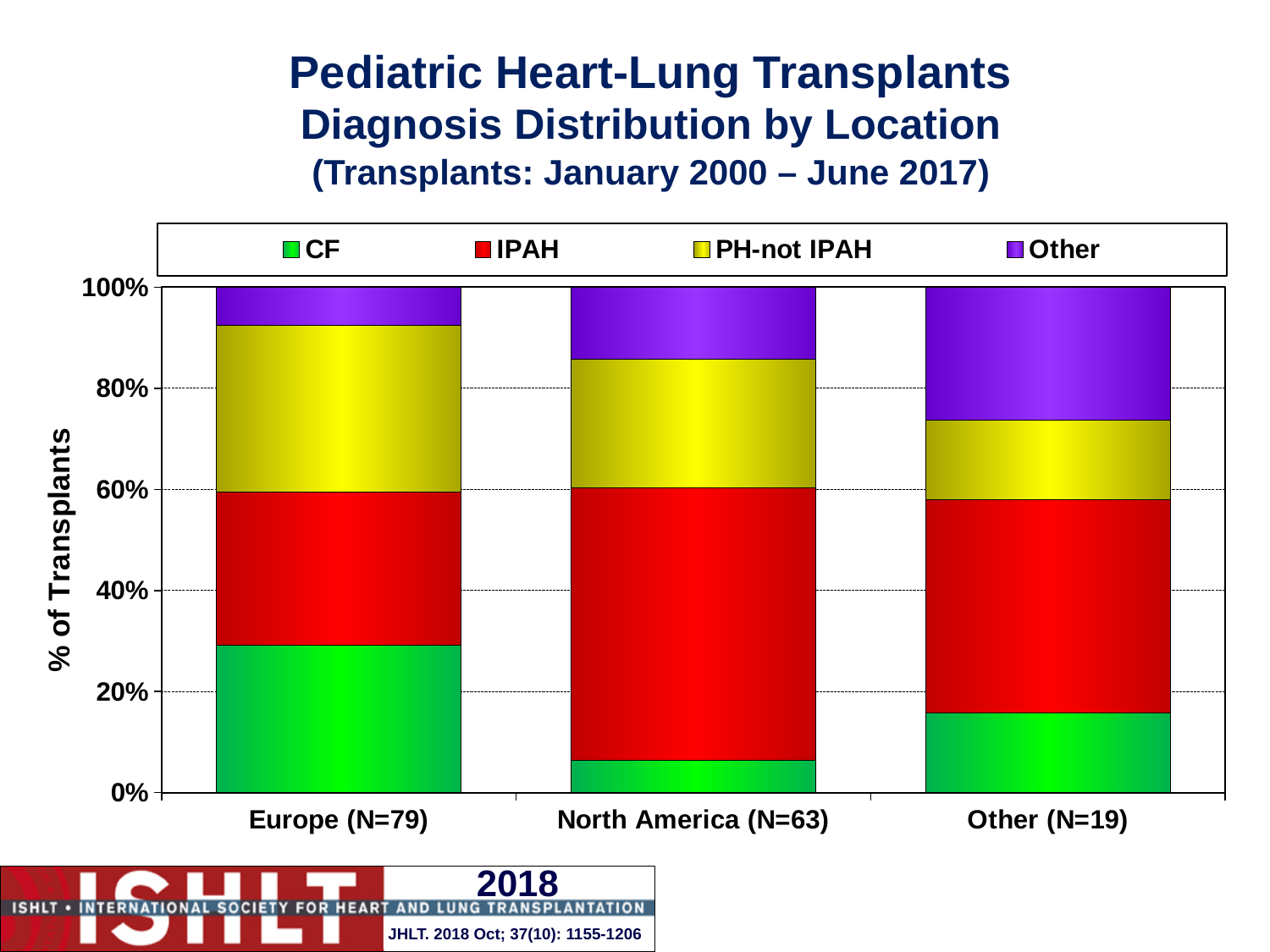
Which location has the smallest CF share of transplants? North America (N=63) Is the CF share for Europe greater or less than 20%? greater How many series does the legend list? 4 How many locations (categories) are shown on the x axis? 3 What kind of chart is shown on the slide? Stacked bar chart Is the CF share for North America greater or less than 20%? less Is the 'Other' diagnosis share for the Other (N=19) location greater or less than 20%? greater Which location has the largest IPAH share of transplants? North America (N=63) What colour represents IPAH in the legend? Red Which location has the largest 'Other' diagnosis share? Other (N=19) Is the IPAH share larger for North America or for Europe? North America Which location has the largest CF share of transplants? Europe (N=79)